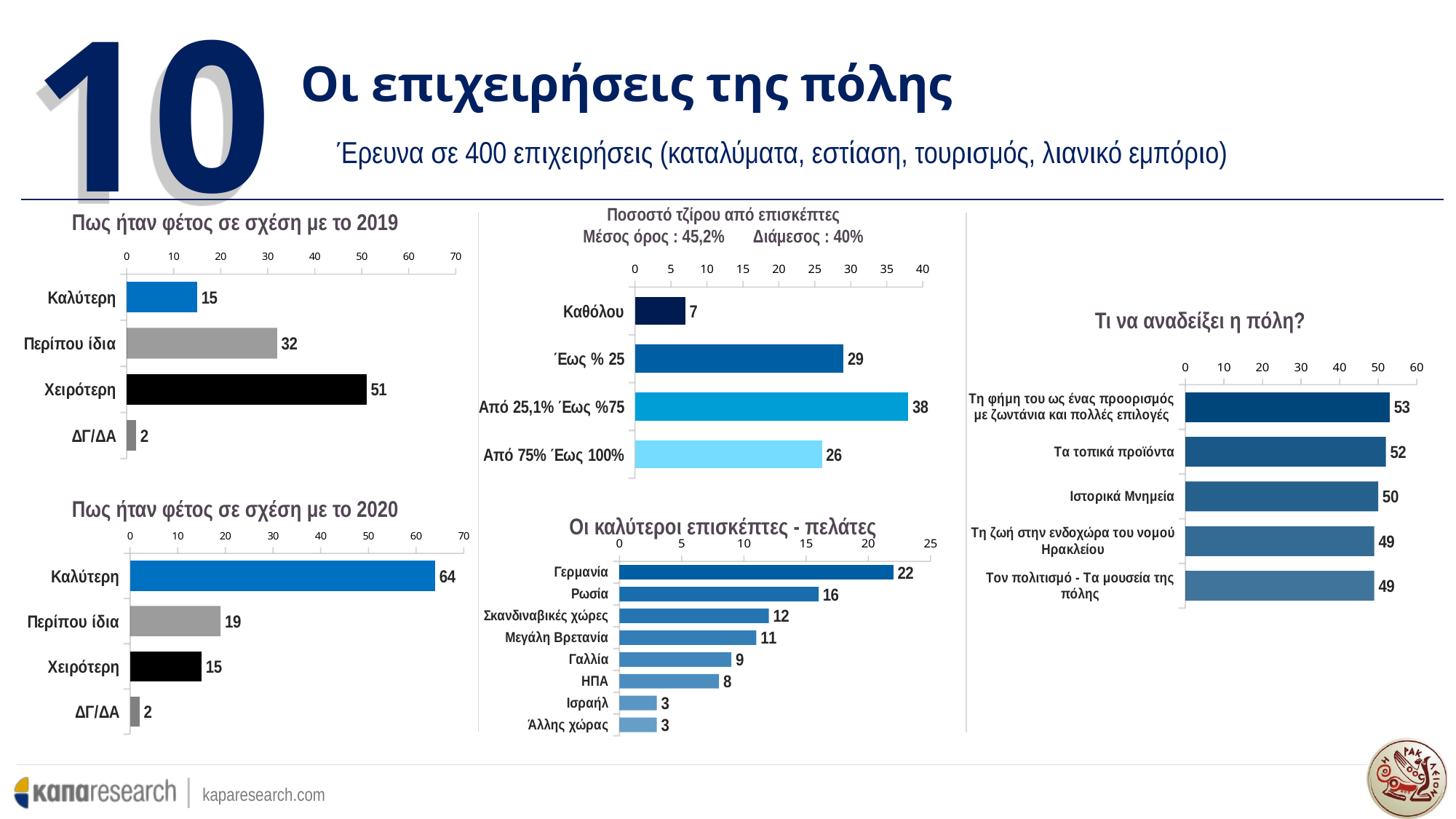
In the chart 'Πως ήταν φέτος σε σχέση με το 2019', what is the value for Χειρότερη? 51 In the chart 'Πως ήταν φέτος σε σχέση με το 2020', which is larger: Περίπου ίδια or Χειρότερη? Περίπου ίδια How many categories are shown in the chart 'Οι καλύτεροι επισκέπτες - πελάτες'? 8 In the chart 'Τι να αναδείξει η πόλη?', what is the value for Ιστορικά Μνημεία? 50 In the chart 'Πως ήταν φέτος σε σχέση με το 2020', what is the value for Καλύτερη? 64 In the chart 'Ποσοστό τζίρου από επισκέπτες', what is the value for Καθόλου? 7 In the chart 'Οι καλύτεροι επισκέπτες - πελάτες', what is the value for Ρωσία? 16 In the chart 'Ποσοστό τζίρου από επισκέπτες', which category has the highest value? Από 25,1% Έως %75 What type of chart is 'Τι να αναδείξει η πόλη?'? Bar chart In the chart 'Οι καλύτεροι επισκέπτες - πελάτες', what is the difference between Γερμανία and Γαλλία? 13 In the chart 'Πως ήταν φέτος σε σχέση με το 2019', which category has the lowest value? ΔΓ/ΔΑ In the chart 'Πως ήταν φέτος σε σχέση με το 2020', what is the difference between Καλύτερη and Περίπου ίδια? 45